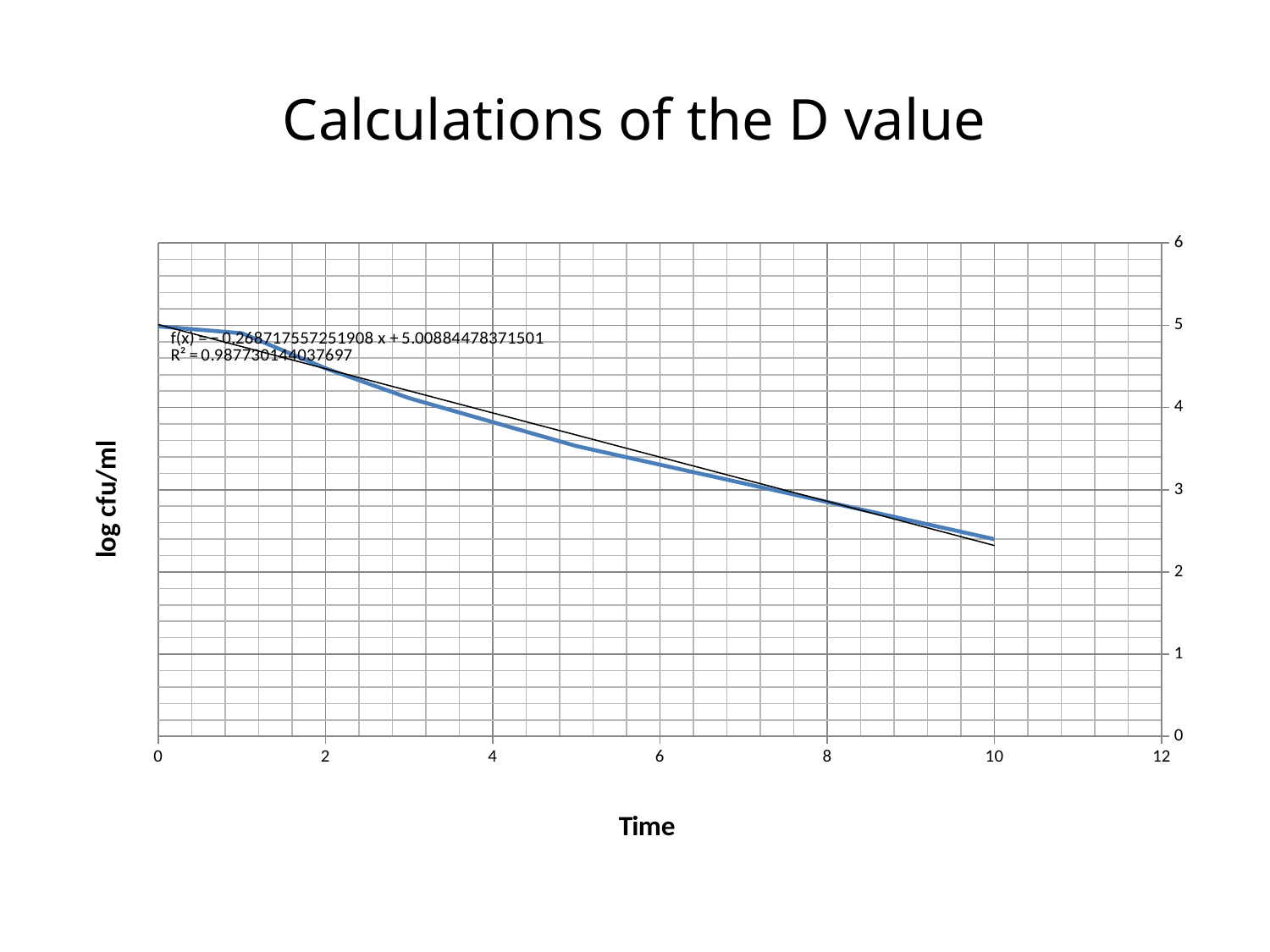
What kind of chart is shown on the slide? line chart Is the value of log cfu/ml at Time 2 greater or less than 4? greater Do the values of log cfu/ml rise or fall as Time increases? fall What is the title of the horizontal axis? Time At which plotted Time is log cfu/ml lowest? 10 Is the value of log cfu/ml at Time 2 greater or less than 5? less Is the value of log cfu/ml at Time 10 greater or less than 3? less What R² value is printed on the chart for the trendline? 0.987730144037697